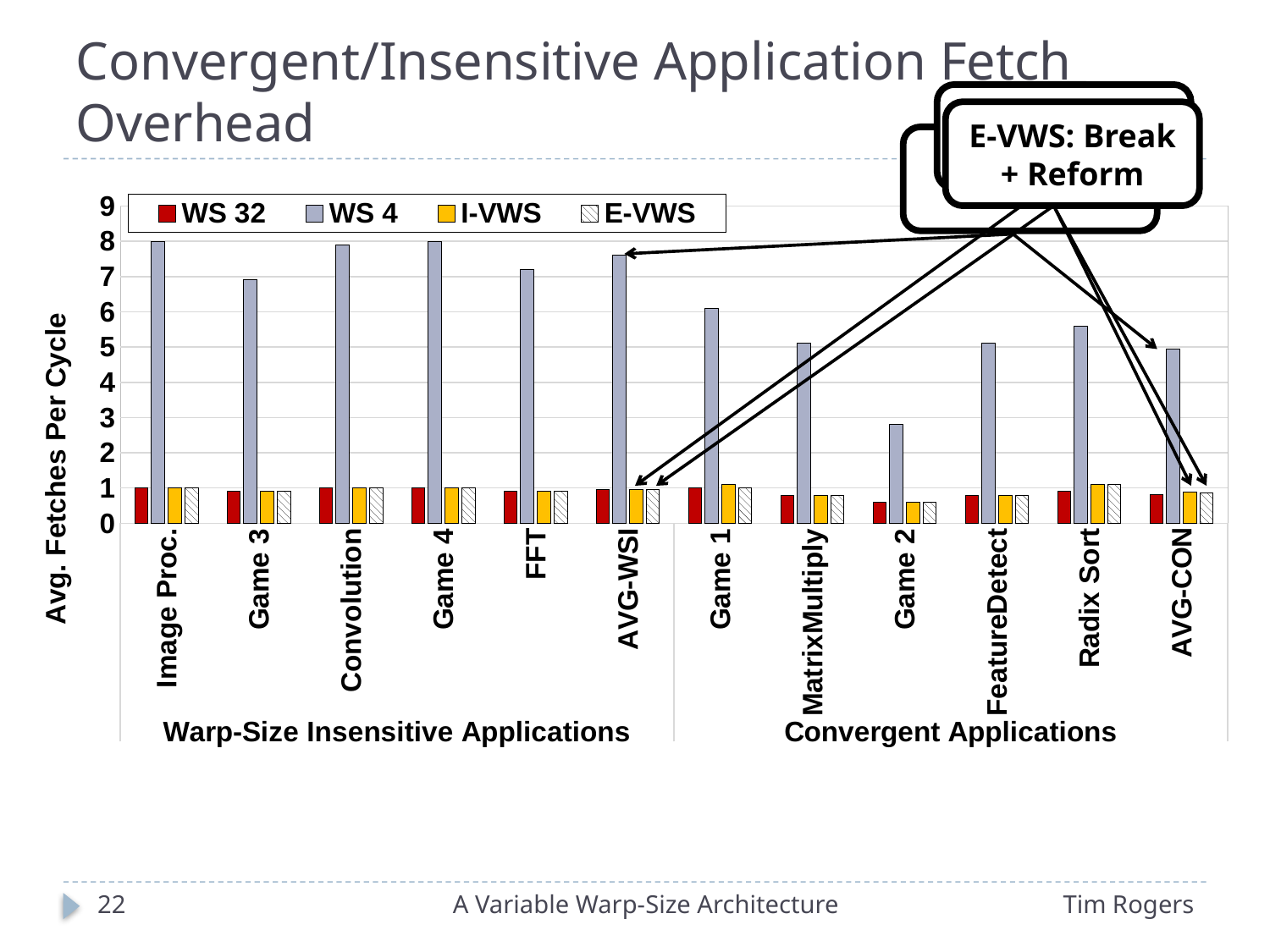
Is the WS 4 value for Game 2 greater or less than 4? less How many series does the legend list? 4 What is the y-axis title of the chart? Avg. Fetches Per Cycle How many application categories are plotted along the x axis? 12 Is the WS 4 value for Game 1 greater or less than 5? greater Is the WS 4 value for Game 3 greater or less than 6? greater Which has the larger WS 4 value, Game 3 or Game 2? Game 3 Which series are listed in the legend? WS 32, WS 4, I-VWS, E-VWS What kind of chart is shown on the slide? bar chart Which has the larger WS 4 value, Image Proc. or Game 1? Image Proc. Which category has the lowest WS 4 value? Game 2